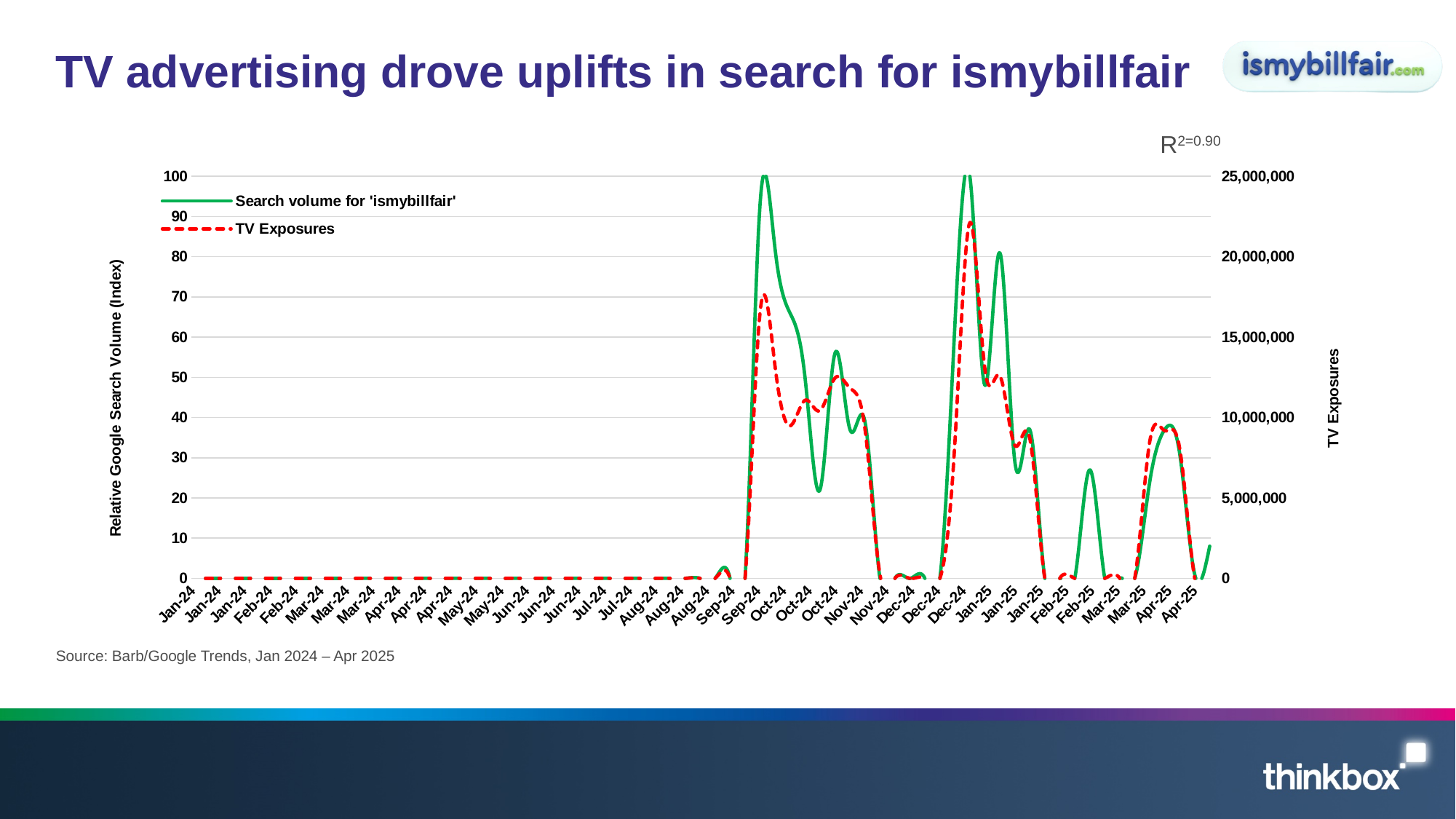
Which series is drawn as a red dashed line? TV Exposures Does the search volume for 'ismybillfair' line rise, fall, or stay flat between Jan-24 and Aug-24? stay flat Is the peak of the search volume line in Feb-25 greater or less than 20? greater What is the highest value reached by the search volume for 'ismybillfair' line on the left axis? 100 Is the highest peak of the TV Exposures line, around Dec-24, greater or less than 20,000,000? greater What R-squared value is shown above the chart? 0.90 What kind of chart is shown on the slide? line chart What are the two series named in the legend? Search volume for 'ismybillfair' and TV Exposures How many series does the chart's legend list? 2 What is the value of the search volume for 'ismybillfair' line at Jan-24? 0 Is the first large peak of the TV Exposures line, around Sep-24/Oct-24, greater or less than 20,000,000? less